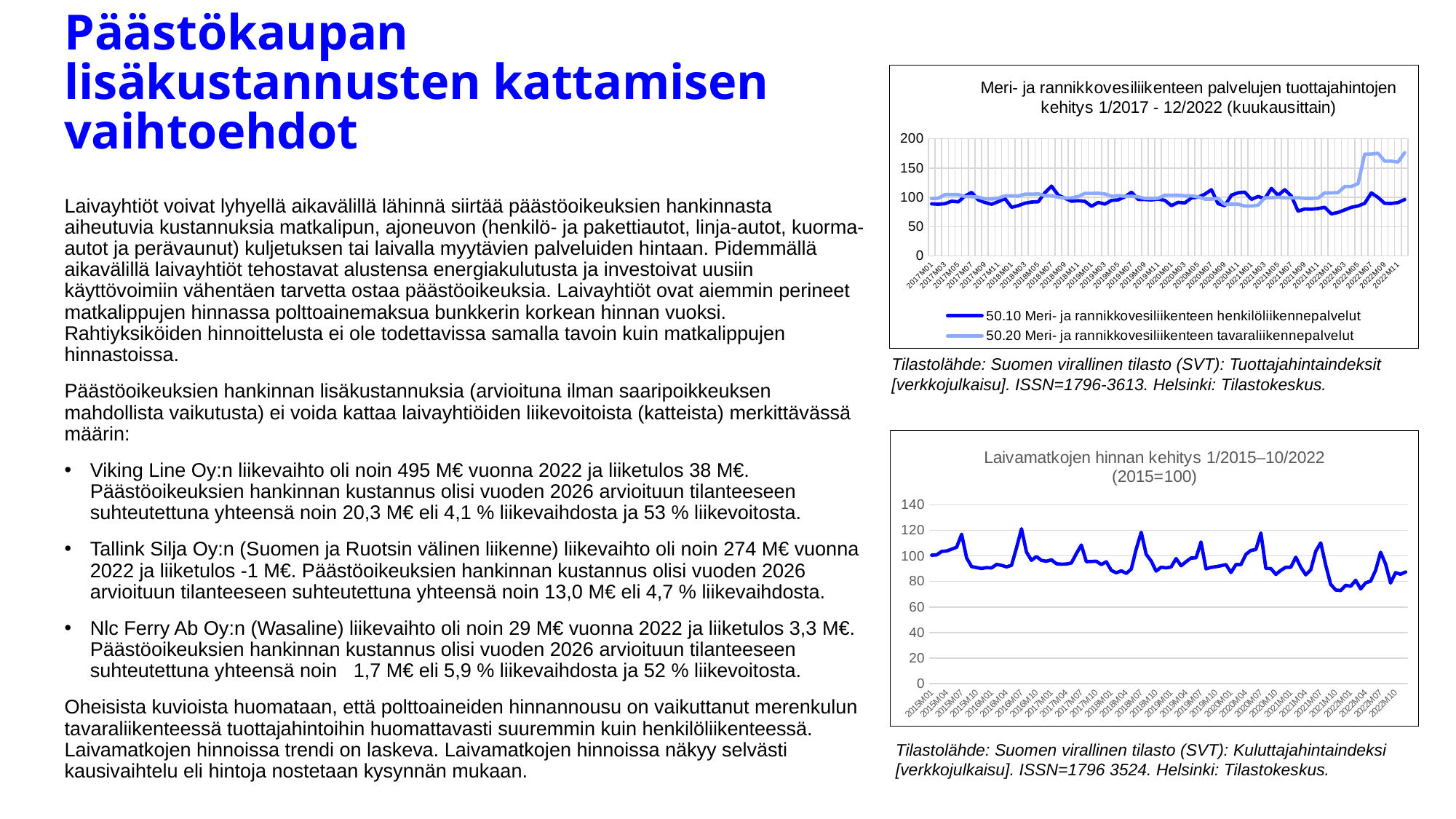
What kind of chart is the top chart titled "Meri- ja rannikkovesiliikenteen palvelujen tuottajahintojen kehitys"? Line chart In the top chart, which series is higher at the end of 2022: 50.10 henkilöliikennepalvelut or 50.20 tavaraliikennepalvelut? 50.20 Meri- ja rannikkovesiliikenteen tavaraliikennepalvelut In the top chart, is the value of the 50.10 henkilöliikennepalvelut series around 2022M01 greater or less than 100? less In the bottom chart, does the overall level of the index rise or fall from 2015 to 2022? Fall What kind of chart is the bottom chart titled "Laivamatkojen hinnan kehitys"? Line chart What period does the title of the top chart say the data covers? 1/2017 - 12/2022 (kuukausittain) How many series does the legend of the top chart list? 2 In the top chart, is the value of the 50.20 tavaraliikennepalvelut series in late 2022 greater or less than 150? greater In the bottom chart, is the peak value around 2016M07 greater or less than 100? greater In the top chart, which series shows a sharp rise in 2022? 50.20 Meri- ja rannikkovesiliikenteen tavaraliikennepalvelut What is the base year stated in the title of the bottom chart? 2015=100